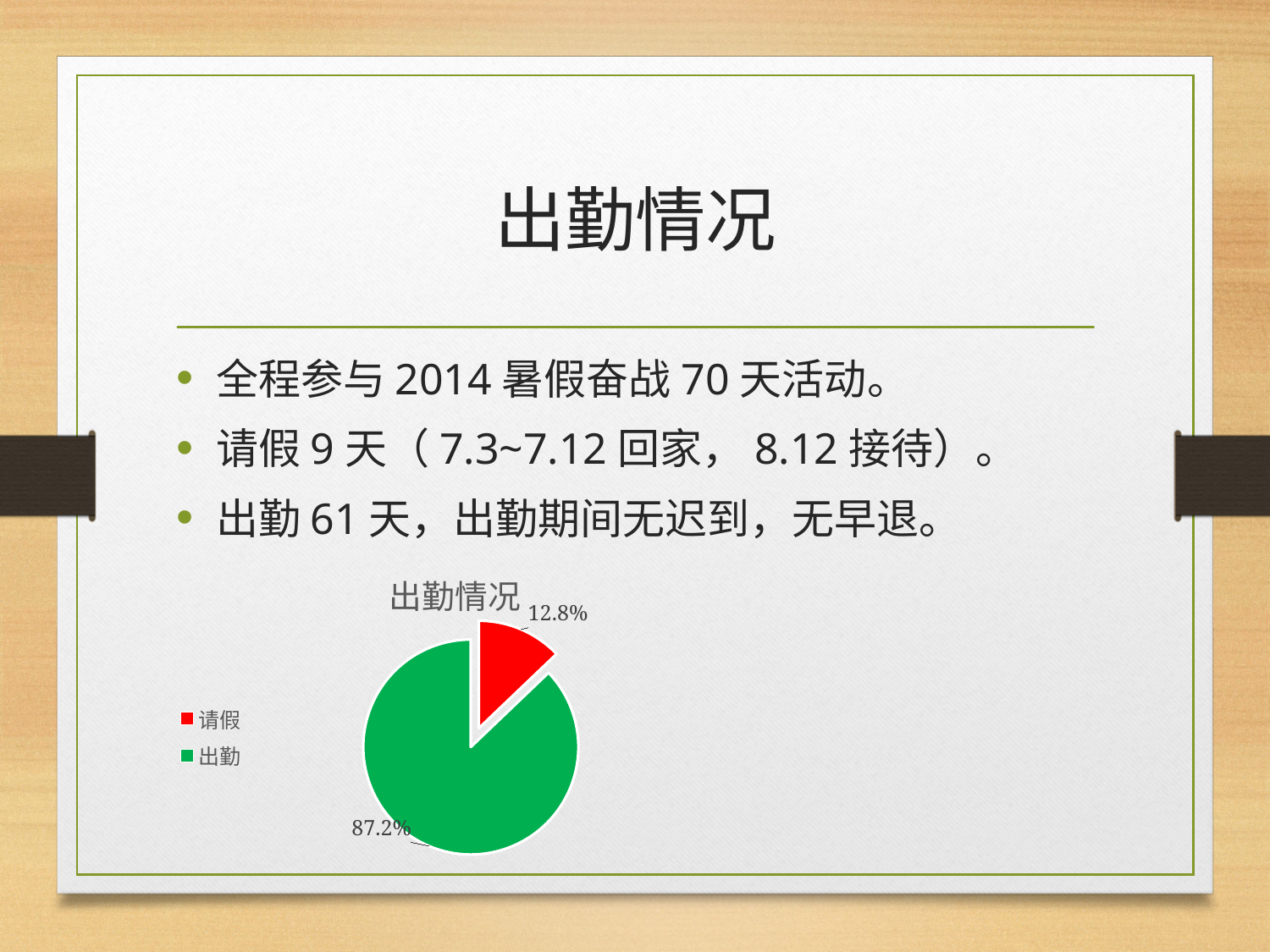
How many slices does the pie chart have? 2 What is the difference in percentage points between the 出勤 share and the 请假 share? 74.4 Which is larger, the share for 请假 or the share for 出勤? 出勤 What share of the pie does 请假 represent? 12.8% What colour is the 请假 slice in the pie chart? red What is the title of the chart? 出勤情况 Which slice of the pie chart is the largest? 出勤 What kind of chart is shown on the slide? pie chart What share of the pie does 出勤 represent? 87.2% How many entries does the chart legend list? 2 Which slice of the pie chart is the smallest? 请假